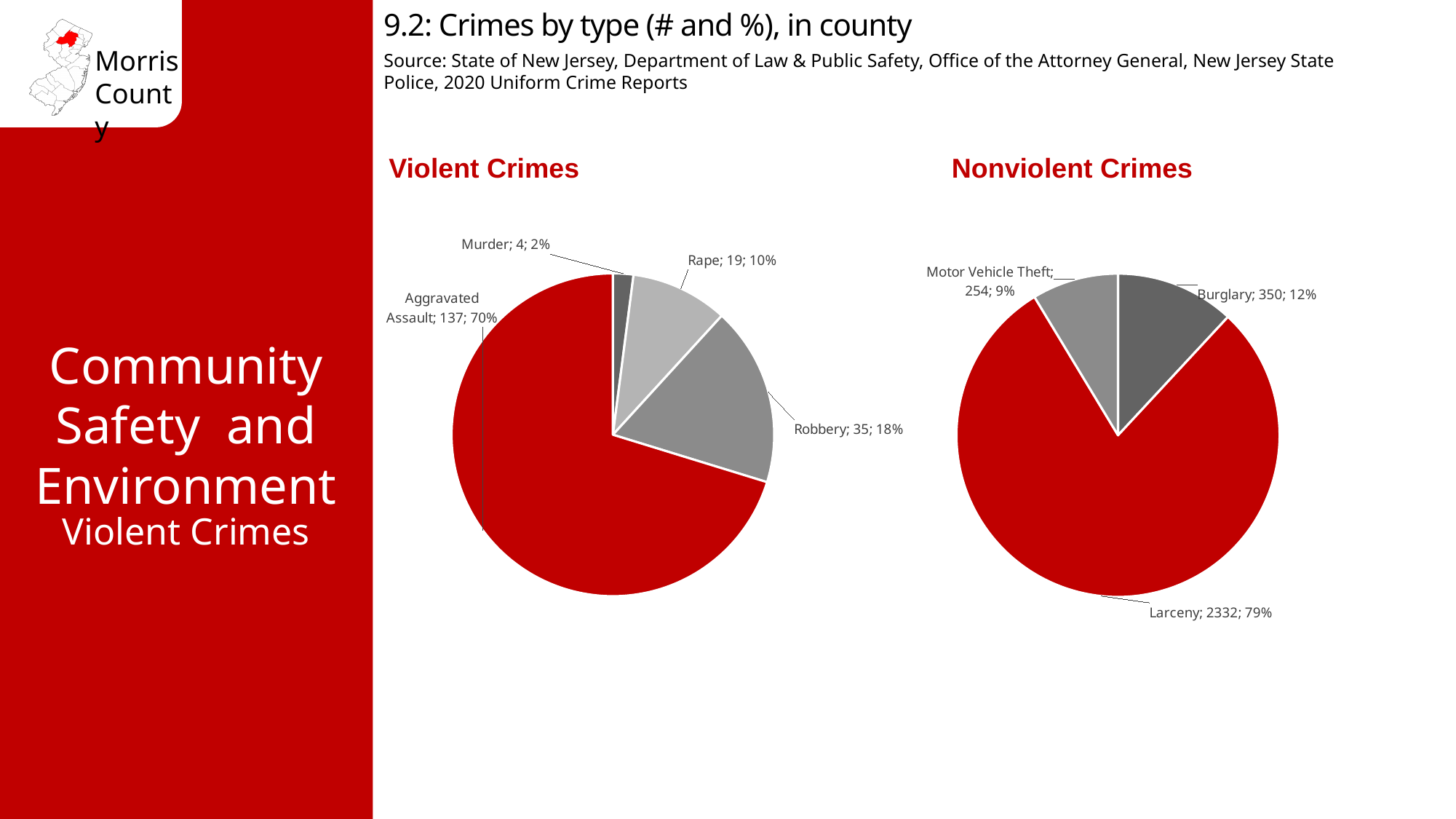
In the Nonviolent Crimes chart, what share of the pie is Motor Vehicle Theft? 9% In the Violent Crimes chart, which category has the largest slice? Aggravated Assault What is the title of the slide's chart section? 9.2: Crimes by type (# and %), in county In the Violent Crimes chart, how many aggravated assaults are shown? 137 In the Violent Crimes chart, what is the difference between the number of robberies and the number of rapes? 16 In the Nonviolent Crimes chart, what is the difference between the number of burglaries and motor vehicle thefts? 96 In the Violent Crimes chart, how many categories are shown? 4 In the Nonviolent Crimes chart, which is larger, Burglary or Motor Vehicle Theft? Burglary In the Violent Crimes chart, which category has the smallest slice? Murder In the Nonviolent Crimes chart, how many larcenies are shown? 2332 In the Violent Crimes chart, what share of the pie is Robbery? 18% What type of chart is the Nonviolent Crimes chart? Pie chart